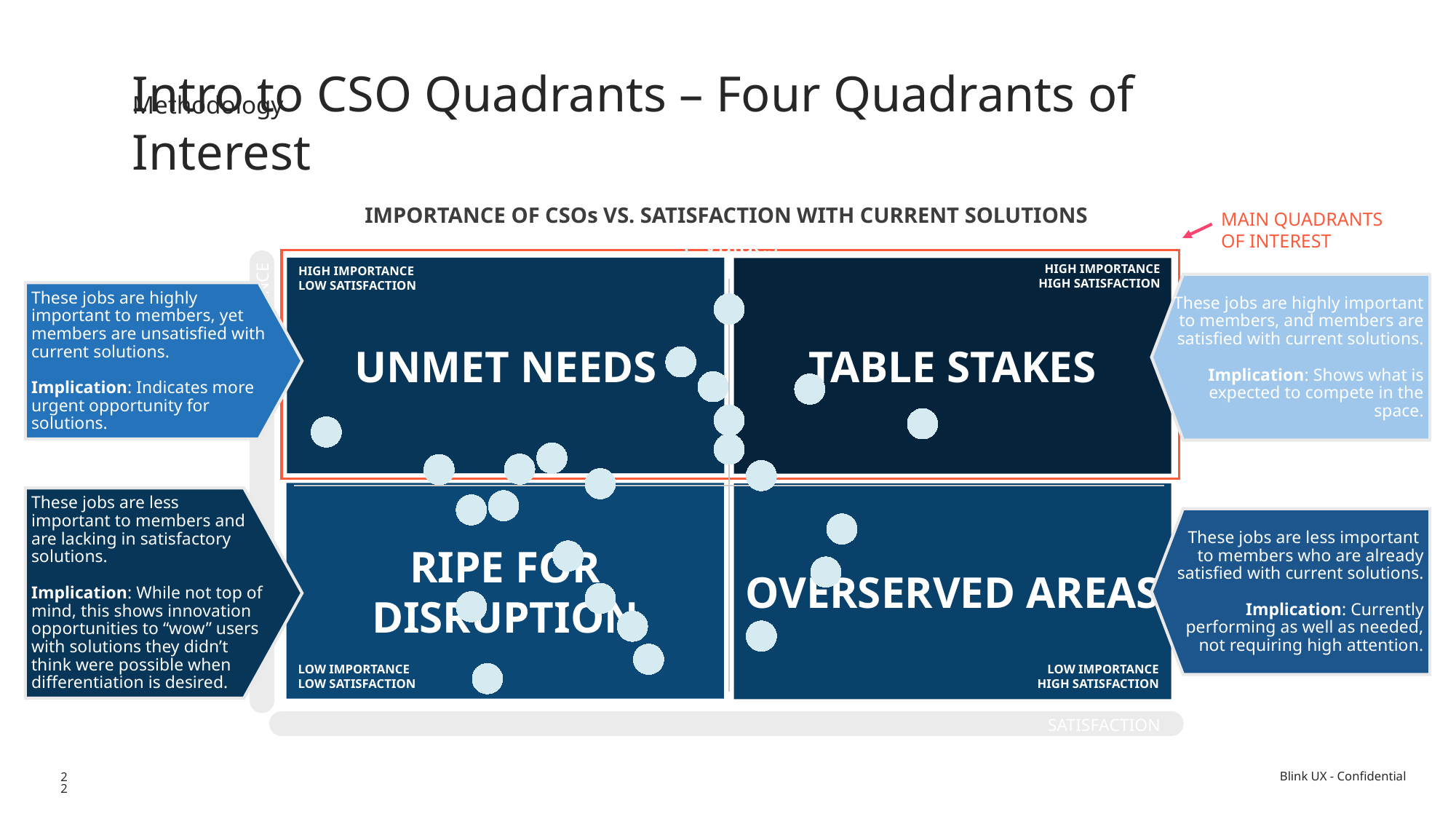
What kind of chart is shown on the slide? scatter chart Which quadrant is labeled HIGH IMPORTANCE / HIGH SATISFACTION? TABLE STAKES What is the title of the chart? IMPORTANCE OF CSOs VS. SATISFACTION WITH CURRENT SOLUTIONS Which has more plotted points, the RIPE FOR DISRUPTION quadrant or the TABLE STAKES quadrant? RIPE FOR DISRUPTION Are there more plotted points on the low-satisfaction (left) side or the high-satisfaction (right) side of the chart? low-satisfaction (left) side